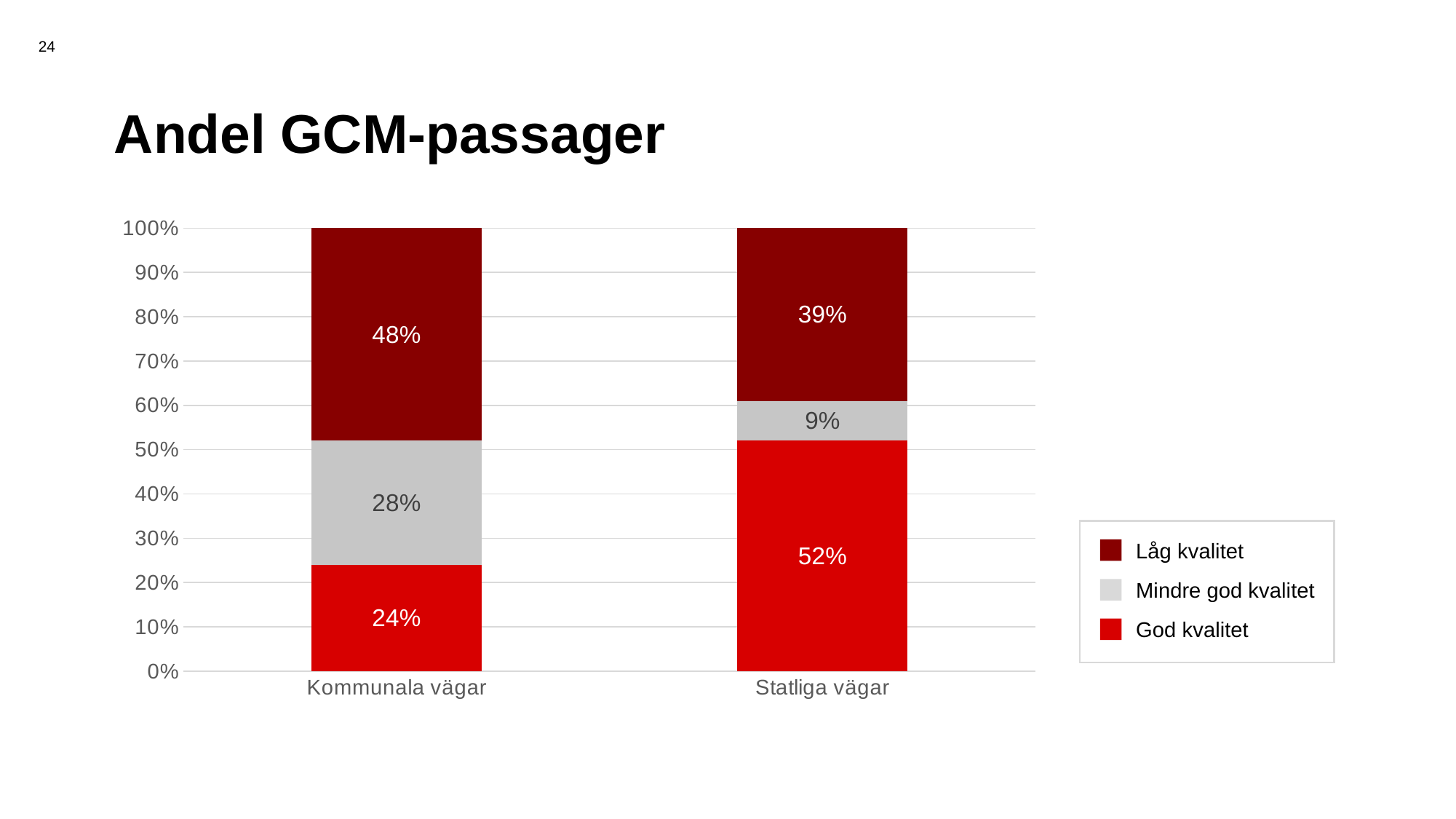
How many categories are shown on the x axis? 2 What is the difference between the Mindre god kvalitet values for Kommunala vägar and Statliga vägar? 19% What is the title of the chart? Andel GCM-passager What is the difference between the God kvalitet values for Statliga vägar and Kommunala vägar? 28% What kind of chart is shown on the slide? Stacked bar chart What is the value for Mindre god kvalitet for Kommunala vägar? 28% What is the value for Mindre god kvalitet for Statliga vägar? 9% Which category has the lower value for Låg kvalitet? Statliga vägar What is the value for Låg kvalitet for Kommunala vägar? 48% Which category has the higher value for God kvalitet? Statliga vägar What is the value for God kvalitet for Statliga vägar? 52% How many series does the legend list? 3